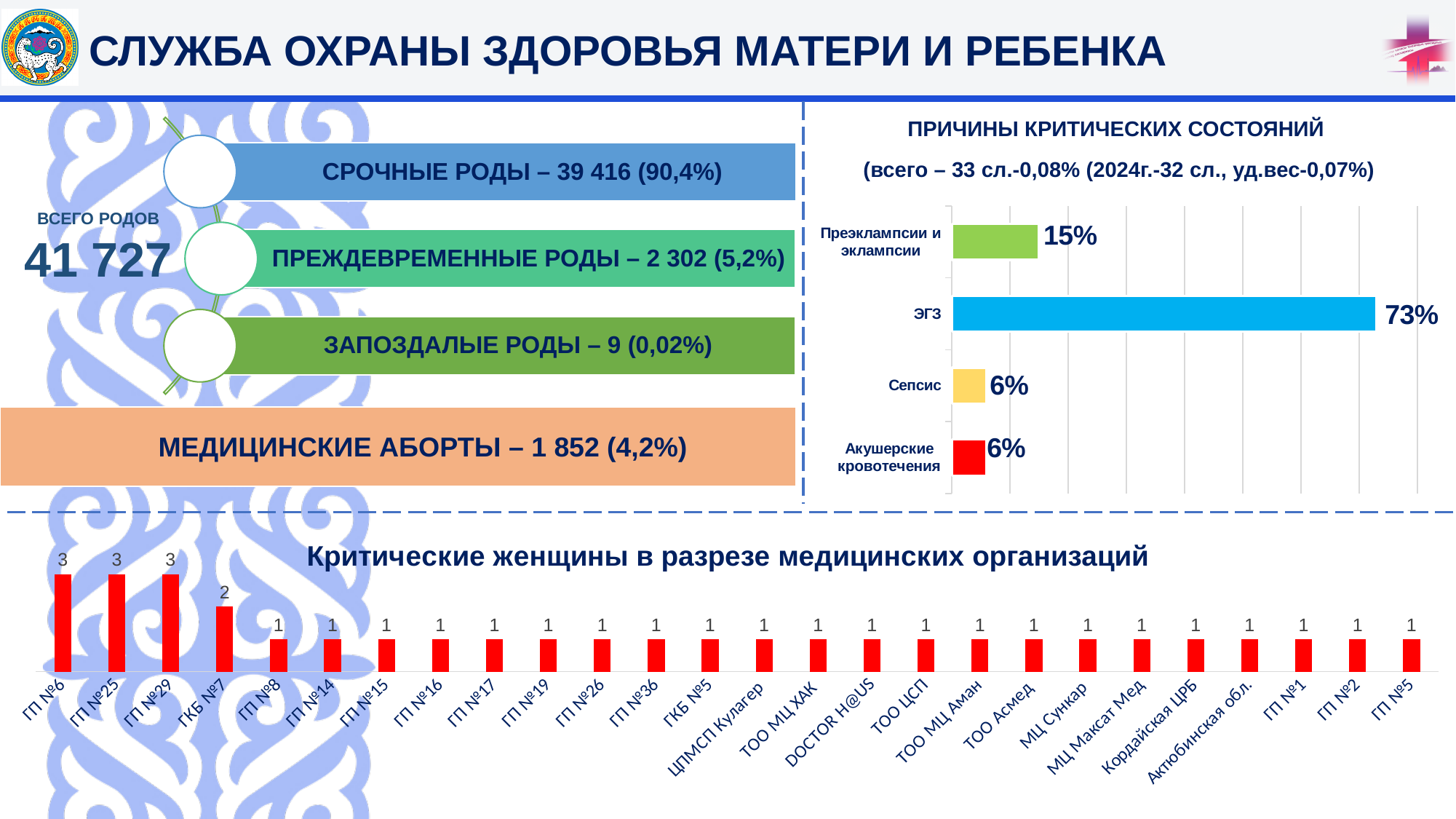
In the chart 'Критические женщины в разрезе медицинских организаций', what is the value for ГКБ №7? 2 In the chart 'ПРИЧИНЫ КРИТИЧЕСКИХ СОСТОЯНИЙ', what is the value for Сепсис? 6% In the chart 'ПРИЧИНЫ КРИТИЧЕСКИХ СОСТОЯНИЙ', what is the difference between the values for ЭГЗ and Преэклампсии и эклампсии? 58% In the chart 'Критические женщины в разрезе медицинских организаций', what is the difference between the values for ГП №29 and ГКБ №7? 1 In the chart 'ПРИЧИНЫ КРИТИЧЕСКИХ СОСТОЯНИЙ', what is the value for ЭГЗ? 73% What kind of chart is 'ПРИЧИНЫ КРИТИЧЕСКИХ СОСТОЯНИЙ'? Bar chart In the chart 'ПРИЧИНЫ КРИТИЧЕСКИХ СОСТОЯНИЙ', which category has the highest value? ЭГЗ In the chart 'ПРИЧИНЫ КРИТИЧЕСКИХ СОСТОЯНИЙ', what is the value for Преэклампсии и эклампсии? 15% In the chart 'Критические женщины в разрезе медицинских организаций', how many organisations are shown on the x axis? 26 In the chart 'ПРИЧИНЫ КРИТИЧЕСКИХ СОСТОЯНИЙ', how many categories are shown? 4 In the chart 'Критические женщины в разрезе медицинских организаций', which is larger, the value for ГП №6 or the value for ГП №8? ГП №6 In the chart 'Критические женщины в разрезе медицинских организаций', what is the value for ГП №25? 3